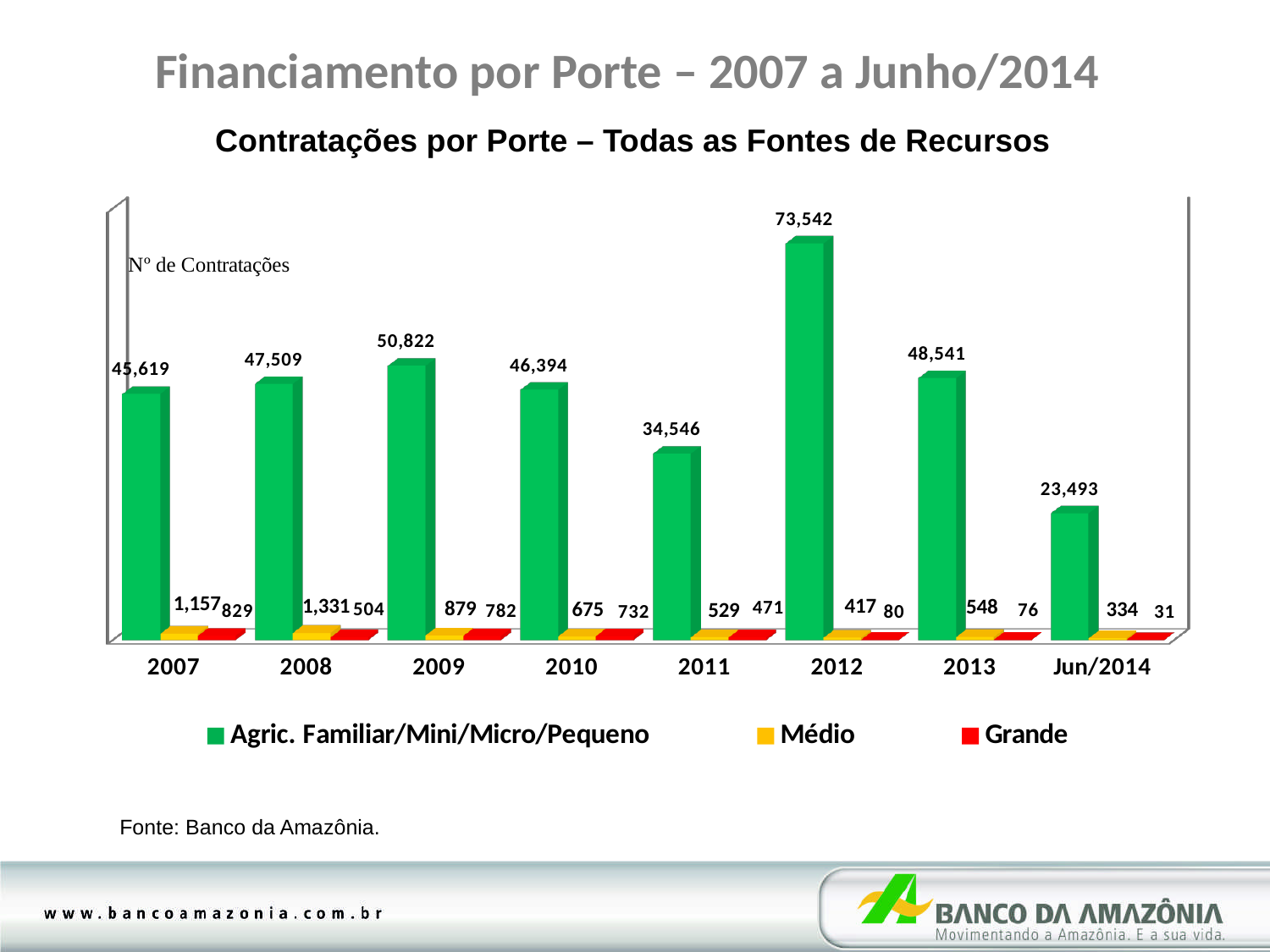
Which colour represents the Grande series? Red What is the value for Médio in 2008? 1,331 What is the value for Agric. Familiar/Mini/Micro/Pequeno in 2012? 73,542 What is the value for Grande in Jun/2014? 31 What is the value for Agric. Familiar/Mini/Micro/Pequeno in 2011? 34,546 How many periods are shown on the x axis? 8 What kind of chart is shown? Bar chart How many series does the legend list? 3 Which is larger, the Médio value in 2007 or the Grande value in 2007? Médio (1,157) In which year is the Agric. Familiar/Mini/Micro/Pequeno value highest? 2012 What is the difference between the Agric. Familiar/Mini/Micro/Pequeno values for 2012 and 2013? 25,001 In which period is the Grande value lowest? Jun/2014